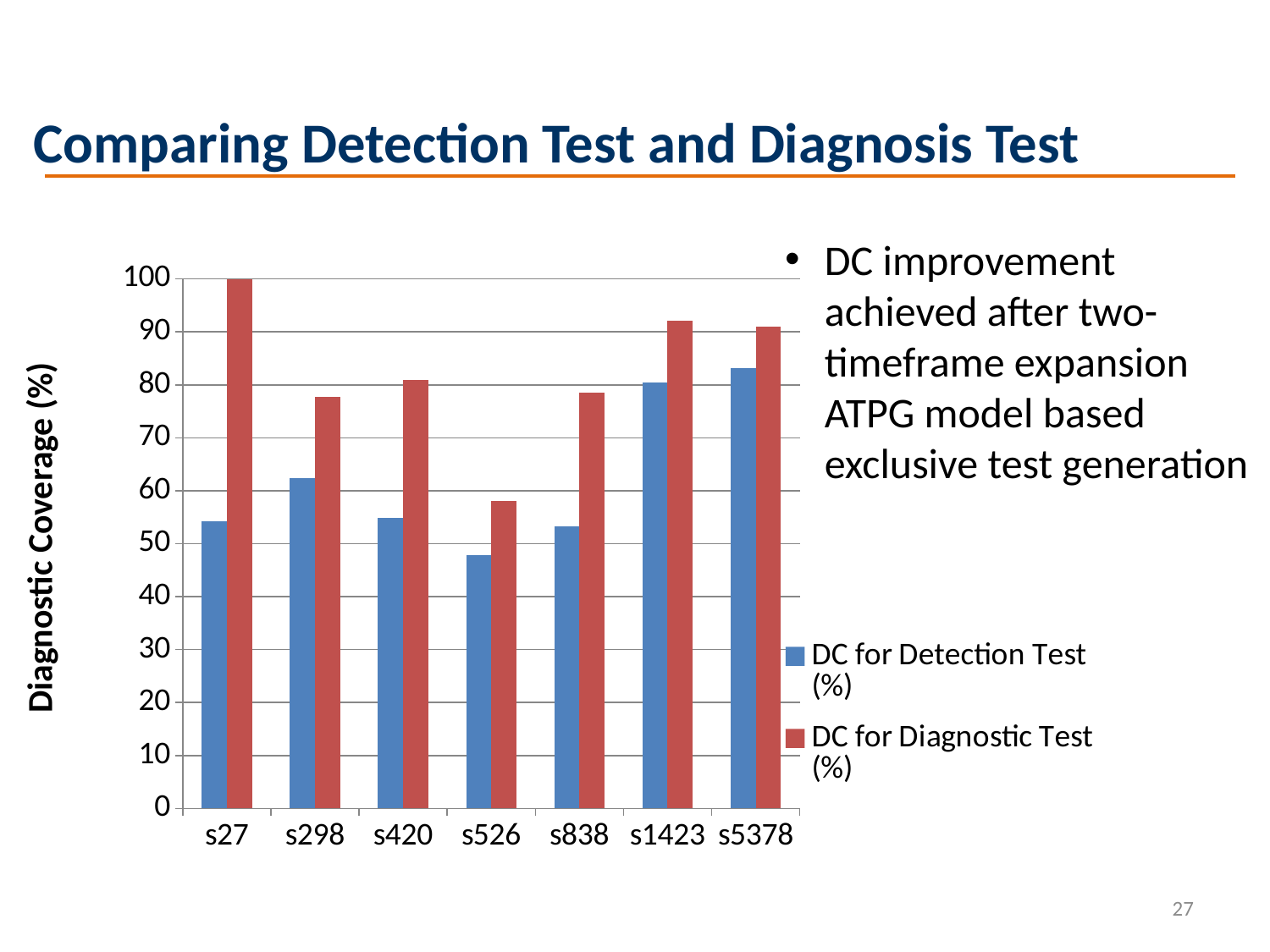
What is the DC for Diagnostic Test (%) value for s27? 100 What kind of chart is shown on the slide? bar chart Is the DC for Diagnostic Test (%) value for s1423 greater or less than 90? greater Is the DC for Detection Test (%) value for s5378 greater or less than 80? greater Which category has the lowest DC for Diagnostic Test (%)? s526 Which category has the highest DC for Diagnostic Test (%)? s27 Is the DC for Detection Test (%) value for s526 greater or less than 50? less For s27, which is larger: DC for Detection Test (%) or DC for Diagnostic Test (%)? DC for Diagnostic Test (%) What is the title of the chart's vertical axis? Diagnostic Coverage (%) Which category has the lowest DC for Detection Test (%)? s526 How many series does the chart's legend list? 2 How many circuit categories are shown on the x axis of the chart? 7